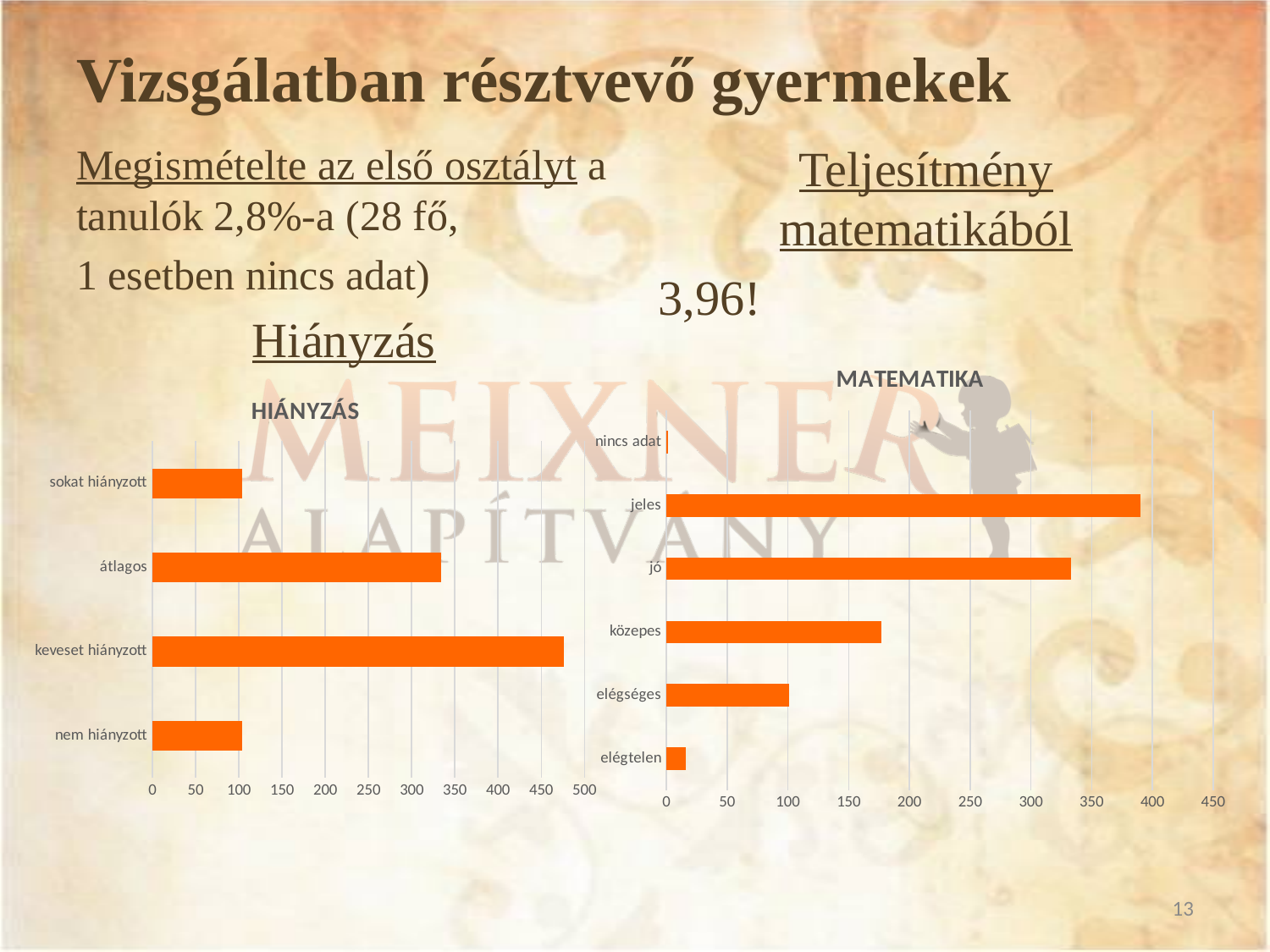
In the MATEMATIKA chart, which category has the lowest value? nincs adat In the MATEMATIKA chart, which is larger, the value for jó or the value for közepes? jó In the HIÁNYZÁS chart, is the value for keveset hiányzott greater or less than 450? greater What kind of chart is the HIÁNYZÁS chart? bar chart In the HIÁNYZÁS chart, which category has the highest value? keveset hiányzott In the MATEMATIKA chart, is the value for közepes greater or less than 150? greater In the MATEMATIKA chart, which category has the highest value? jeles How many categories does the HIÁNYZÁS chart show? 4 In the HIÁNYZÁS chart, is the value for sokat hiányzott greater or less than 150? less How many categories does the MATEMATIKA chart show? 6